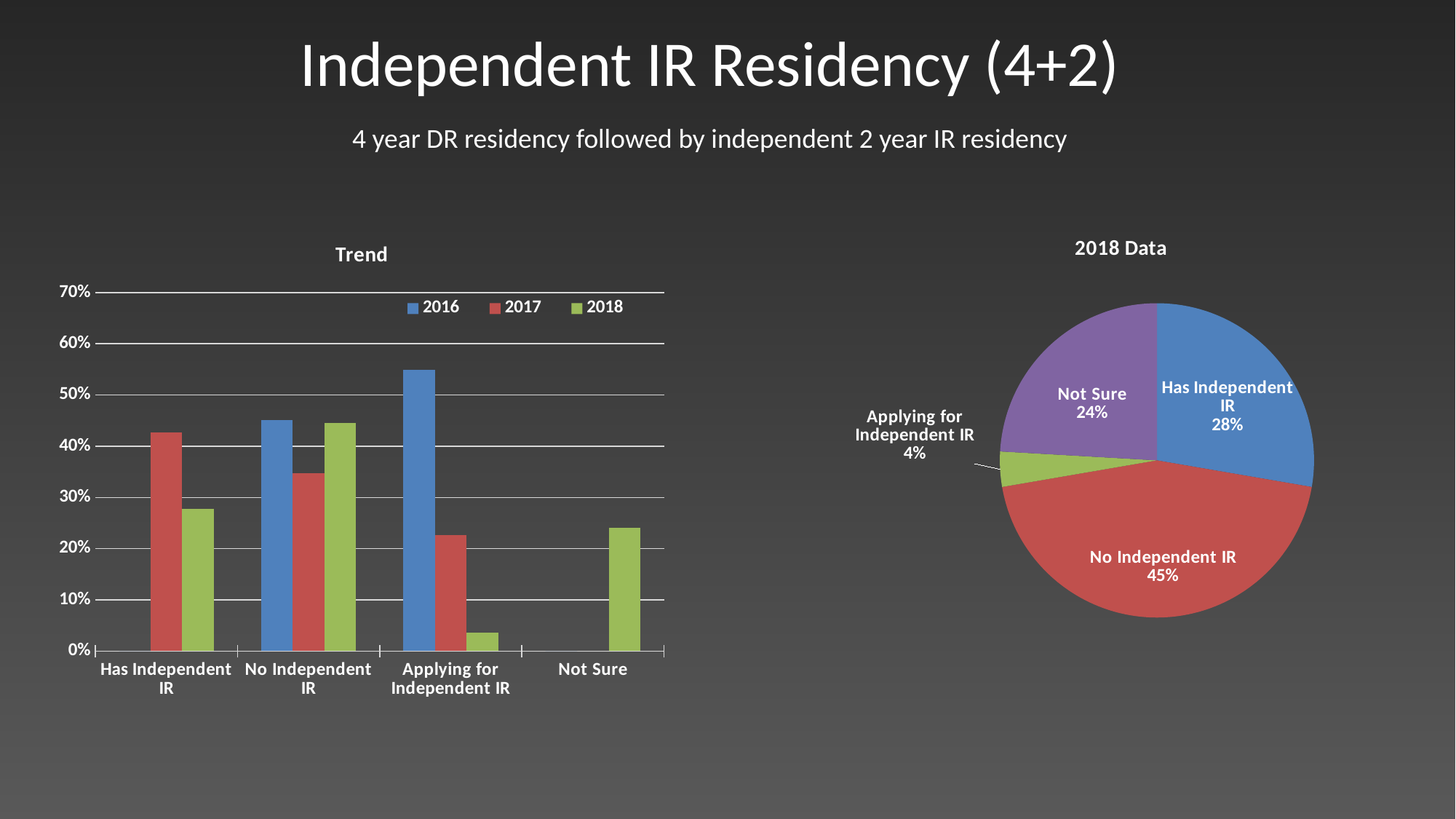
What kind of chart is the 'Trend' chart? bar chart In the '2018 Data' pie chart, what share is labelled for 'Not Sure'? 24% In the '2018 Data' pie chart, which slice is the largest? No Independent IR In the 'Trend' chart, is the 2017 value for 'No Independent IR' greater or less than 40%? less In the '2018 Data' pie chart, what share is labelled for 'Has Independent IR'? 28% In the '2018 Data' pie chart, what share is labelled for 'No Independent IR'? 45% In the 'Trend' chart, is the 2016 value for 'Applying for Independent IR' greater or less than 50%? greater In the '2018 Data' pie chart, which slice is the smallest? Applying for Independent IR How many slices does the '2018 Data' pie chart have? 4 In the '2018 Data' pie chart, what is the difference between the 'No Independent IR' share and the 'Has Independent IR' share? 17% In the 'Trend' chart, which is larger for 'Has Independent IR': the 2017 value or the 2018 value? 2017 How many series does the legend of the 'Trend' chart list? 3